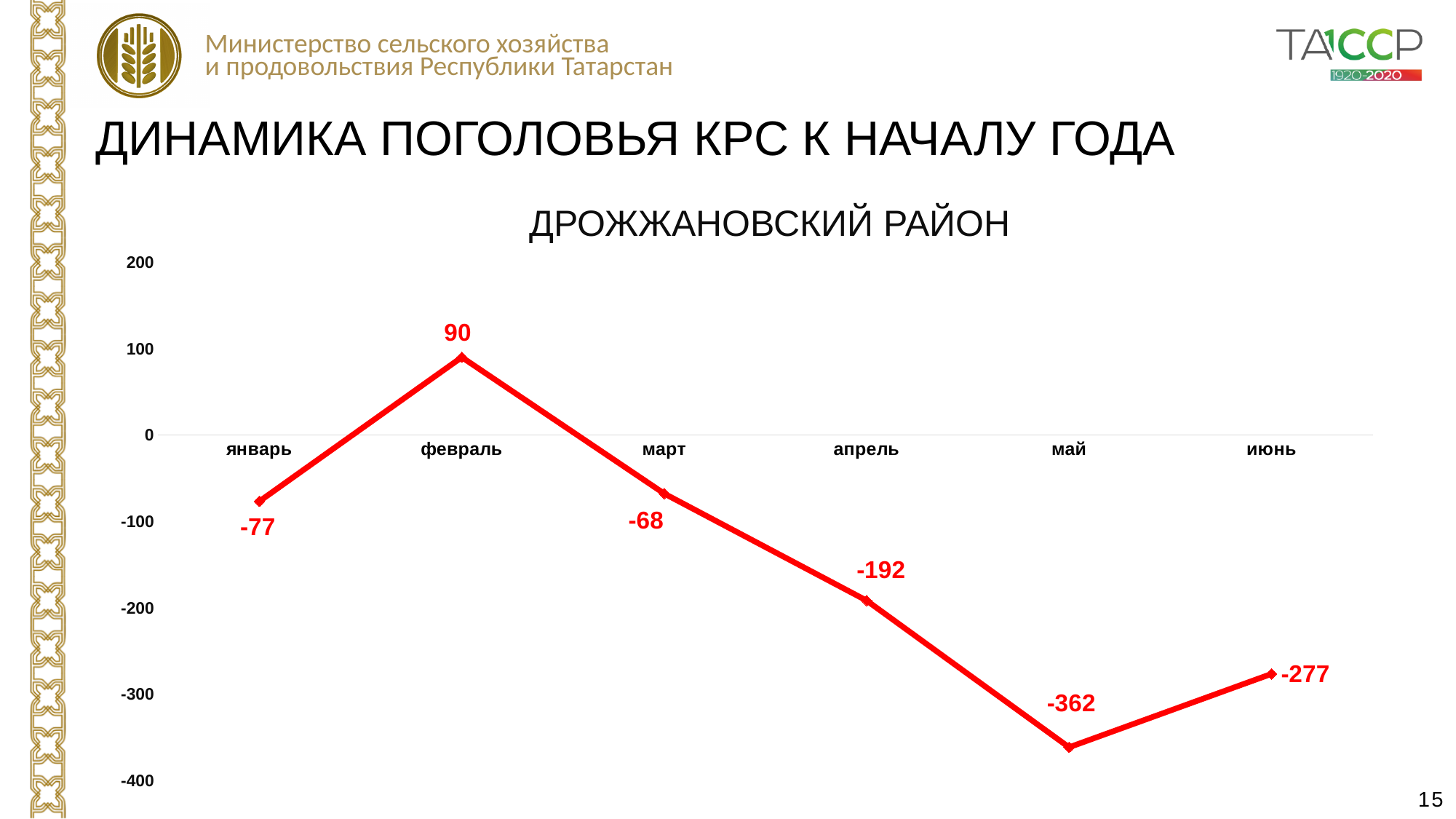
What kind of chart is shown? line chart What is the value for июнь? -277 What is the title of the chart? ДРОЖЖАНОВСКИЙ РАЙОН What is the value for май? -362 What is the value for февраль? 90 Which month has the lowest value? май What is the value for январь? -77 Which is larger, the value for апрель or the value for июнь? апрель How many months are plotted on the chart? 6 What is the difference between the values for февраль and март? 158 Which month has the highest value? февраль Is the value for апрель greater or less than -100? less